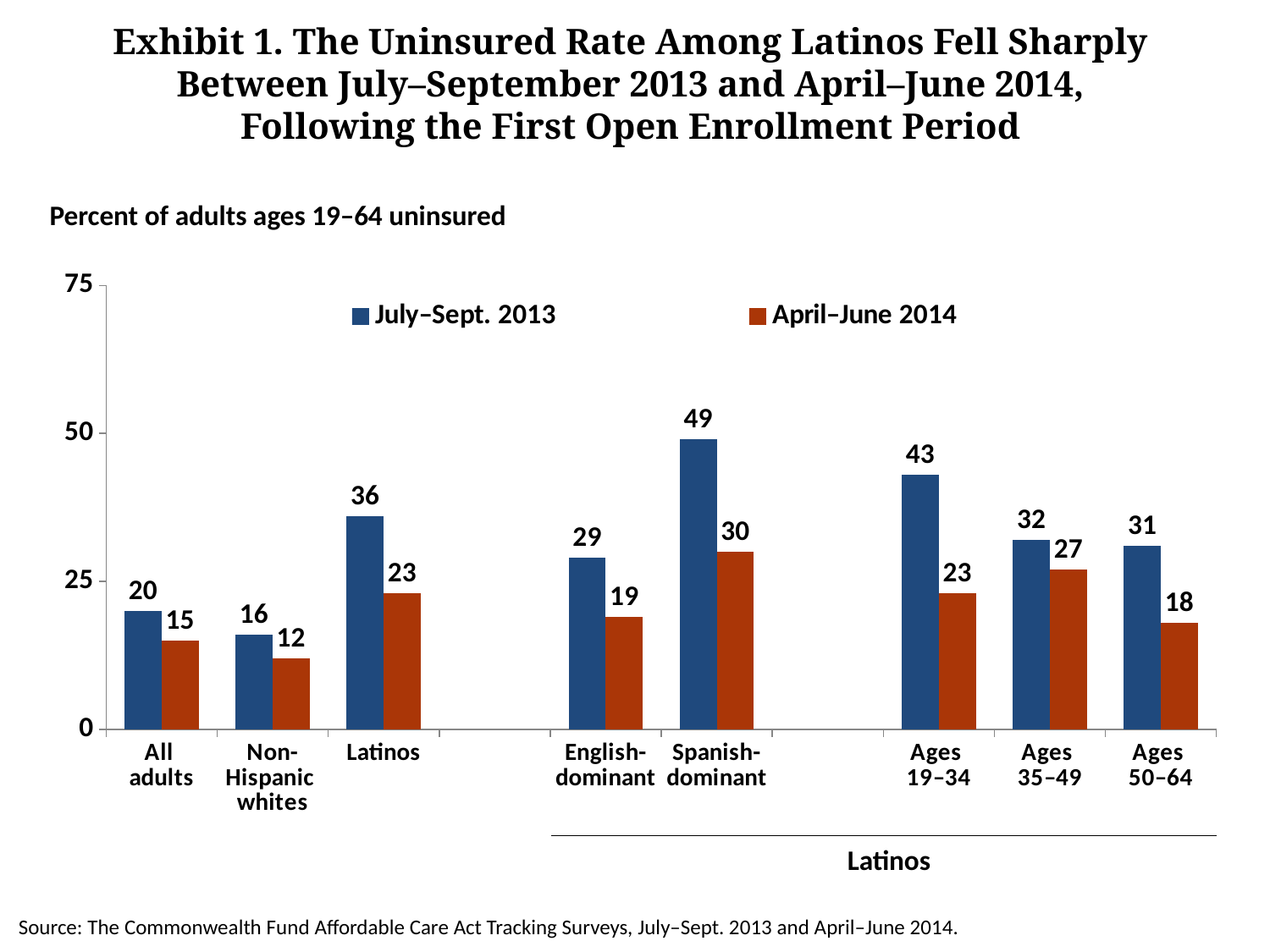
What is the July–Sept. 2013 uninsured rate for Latinos? 36 By how many percentage points did the uninsured rate for Latinos ages 19–34 fall between July–Sept. 2013 and April–June 2014? 20 Is the July–Sept. 2013 value for Ages 19–34 greater or less than 50? less How many series does the legend list? 2 What is the April–June 2014 value for Non-Hispanic whites? 12 Which category has the lowest April–June 2014 uninsured rate? Non-Hispanic whites Which is larger: the April–June 2014 value for Ages 35–49 or for Ages 50–64? Ages 35–49 What kind of chart is shown on the slide? bar chart How many categories are shown on the x axis? 8 What is the April–June 2014 uninsured rate for Spanish-dominant Latinos? 30 What is the difference between the July–Sept. 2013 values for Spanish-dominant and English-dominant Latinos? 20 Which category has the highest July–Sept. 2013 uninsured rate? Spanish-dominant